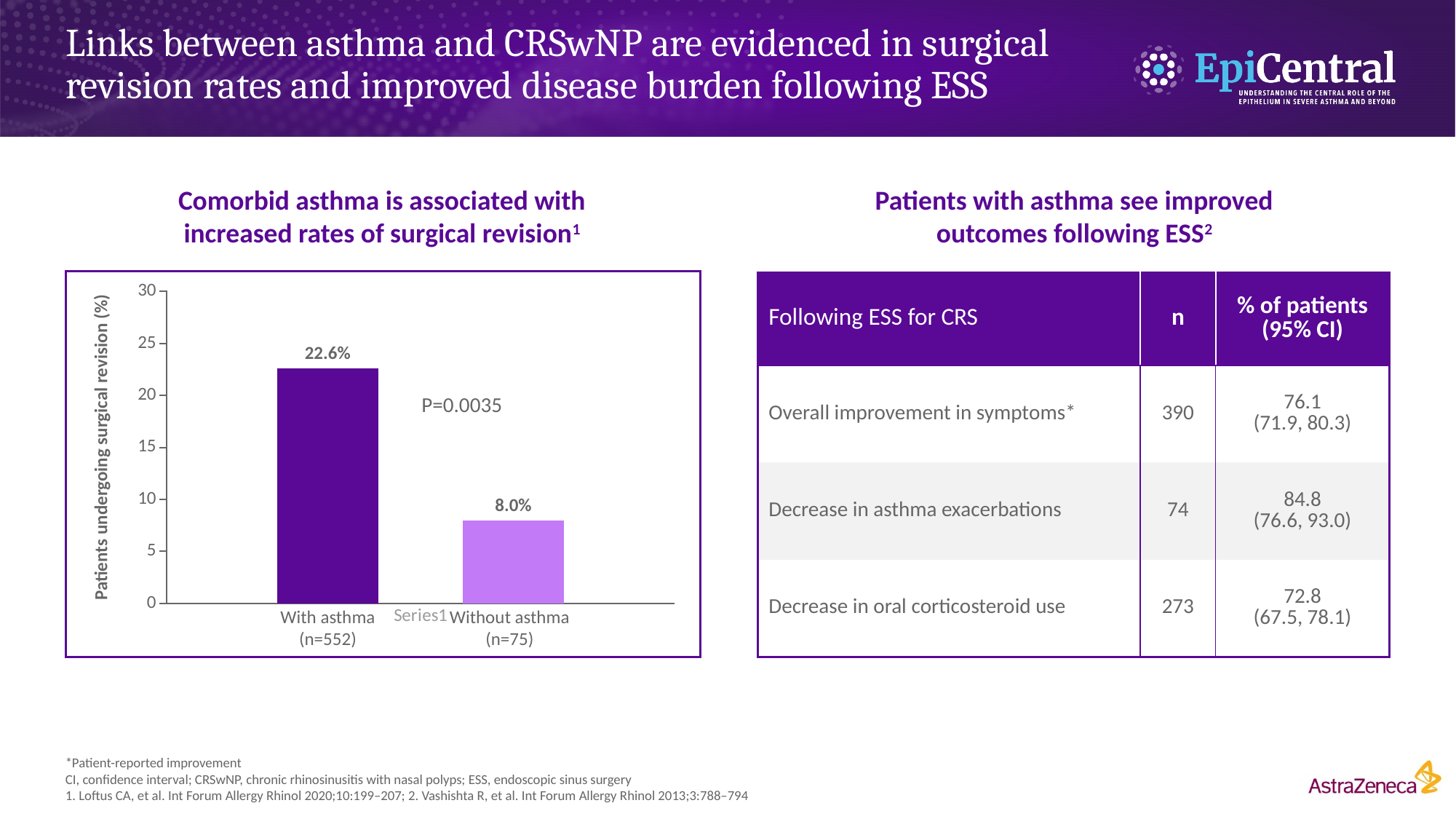
What is the difference in surgical revision rate between patients with asthma and without asthma? 14.6% What is the label of the y-axis of the bar chart? Patients undergoing surgical revision (%) Which group has the lower rate of surgical revision? Without asthma What P value is shown on the bar chart? P=0.0035 What is the maximum value shown on the y-axis of the bar chart? 30 Is the surgical revision rate for patients with asthma greater or less than 20? greater What type of chart is shown on the left of the slide? Bar chart What is the surgical revision rate for patients without asthma? 8.0% How many groups are plotted in the bar chart? 2 Which group has the higher rate of surgical revision? With asthma Is the surgical revision rate for patients without asthma greater or less than 10? less What is the surgical revision rate for patients with asthma? 22.6%